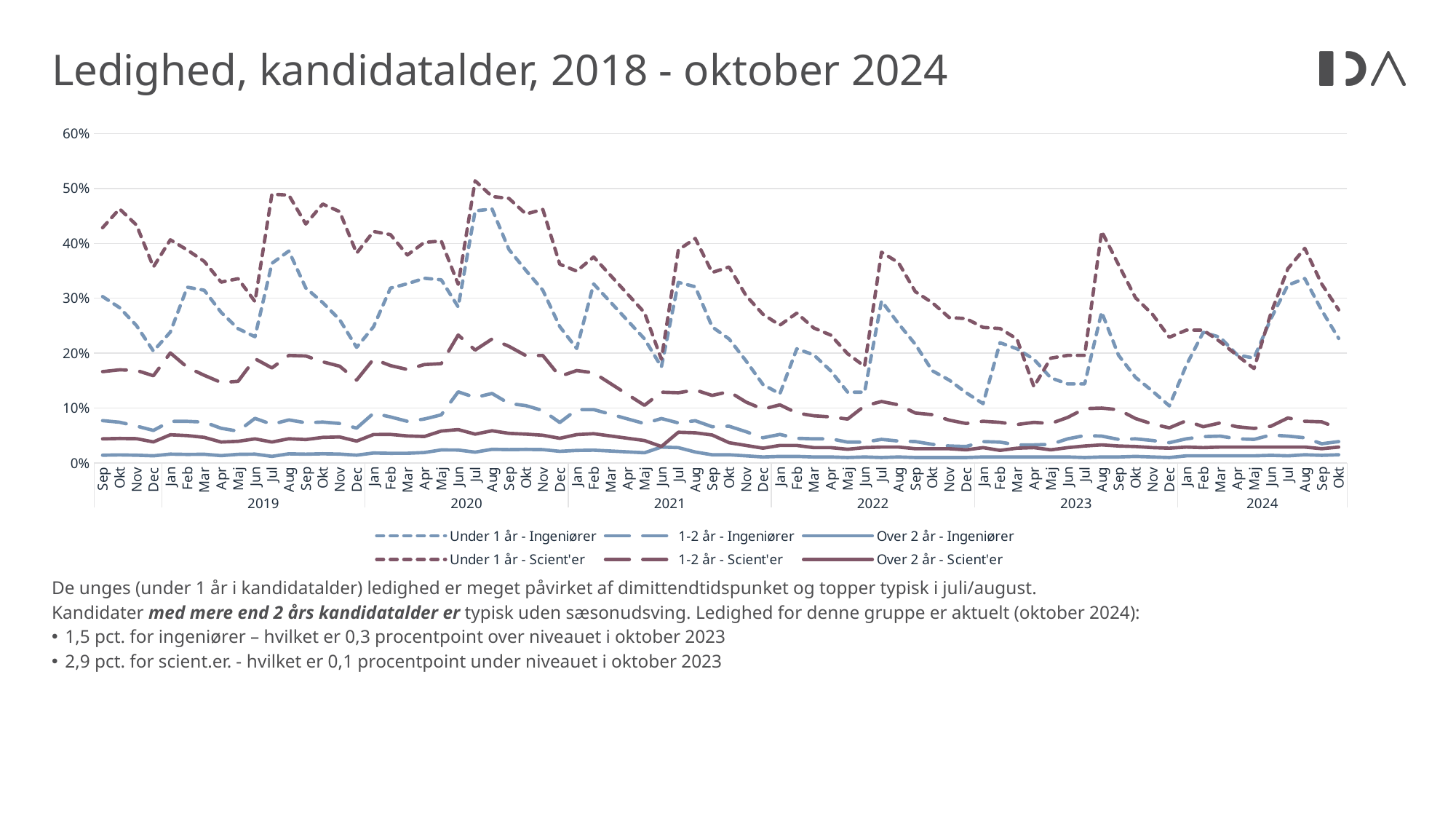
What is the title of the chart? Ledighed, kandidatalder, 2018 - oktober 2024 Is the value for '1-2 år - Scient'er' in Jun 2020 greater or less than 20%? greater In Jul 2020, which is larger: 'Under 1 år - Scient'er' or 'Under 1 år - Ingeniører'? Under 1 år - Scient'er Which series stays lowest across the chart? Over 2 år - Ingeniører What kind of chart is shown on the slide? line chart Is the value for 'Under 1 år - Ingeniører' in Aug 2020 greater or less than 40%? greater Is the value for 'Over 2 år - Ingeniører' in Jul 2020 greater or less than 10%? less How many series does the legend list? 6 Which series reaches the highest value anywhere on the chart? Under 1 år - Scient'er Does the 'Under 1 år - Scient'er' series rise or fall from Aug 2023 to Dec 2023? fall